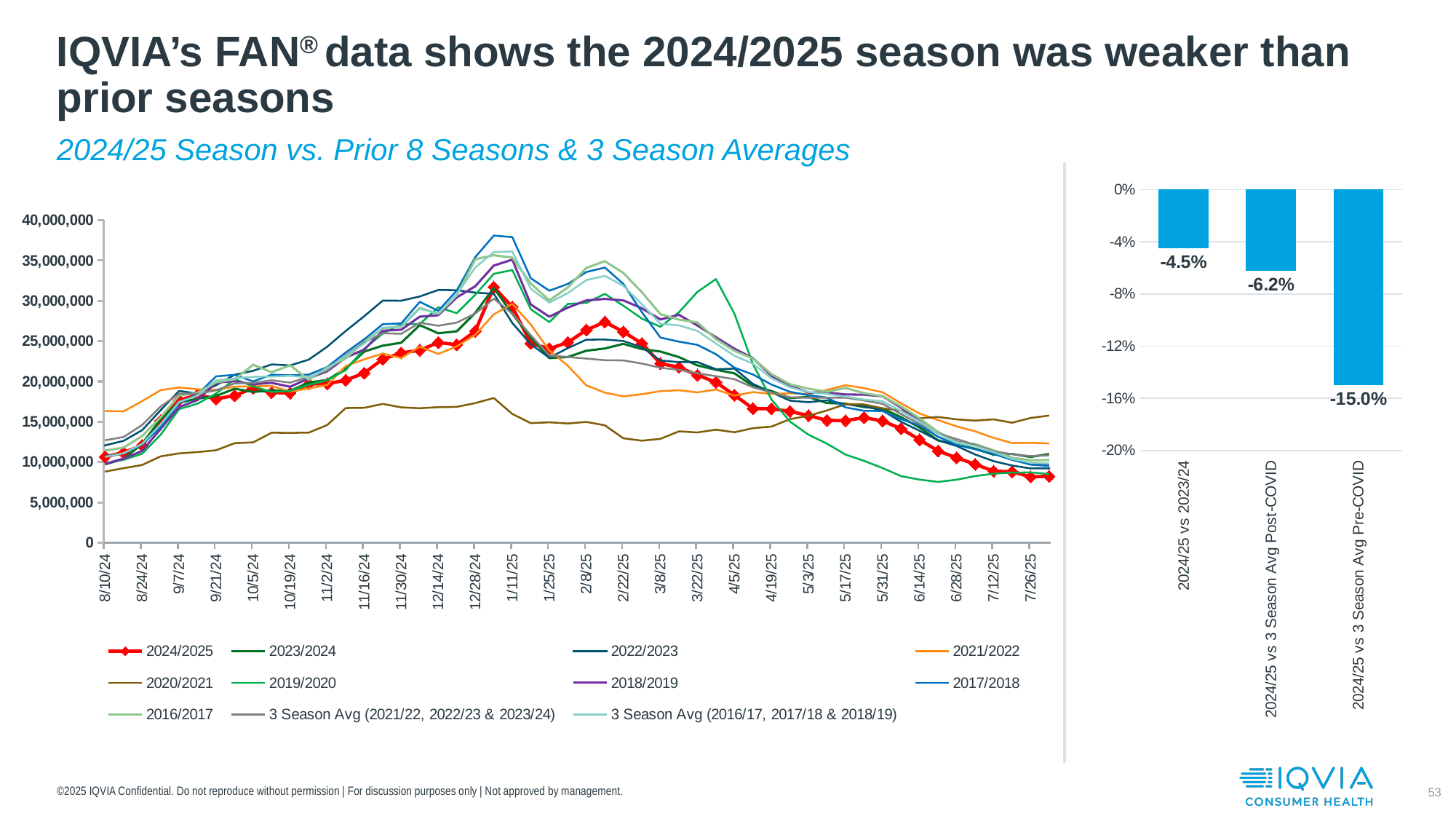
How many series does the legend of the line chart list? 11 In the bar chart on the right, what is the difference between the values for 2024/25 vs 2023/24 and 2024/25 vs 3 Season Avg Post-COVID? 1.7 percentage points In the bar chart on the right, which category has the lowest value? 2024/25 vs 3 Season Avg Pre-COVID In the bar chart on the right, what is the value for 2024/25 vs 2023/24? -4.5% What kind of chart is the chart titled '2024/25 Season vs. Prior 8 Seasons & 3 Season Averages'? Line chart In the bar chart on the right, what is the value for 2024/25 vs 3 Season Avg Pre-COVID? -15.0% In the line chart, does the 2024/2025 line rise or fall between 4/19/25 and 7/26/25? Fall What kind of chart is the chart on the right? Bar chart How many bars are in the bar chart on the right? 3 In the bar chart on the right, what is the value for 2024/25 vs 3 Season Avg Post-COVID? -6.2% In the bar chart on the right, which shows the larger decline: 2024/25 vs 2023/24 or 2024/25 vs 3 Season Avg Pre-COVID? 2024/25 vs 3 Season Avg Pre-COVID In the line chart, is the 2020/2021 value at 12/28/24 greater or less than 20,000,000? less